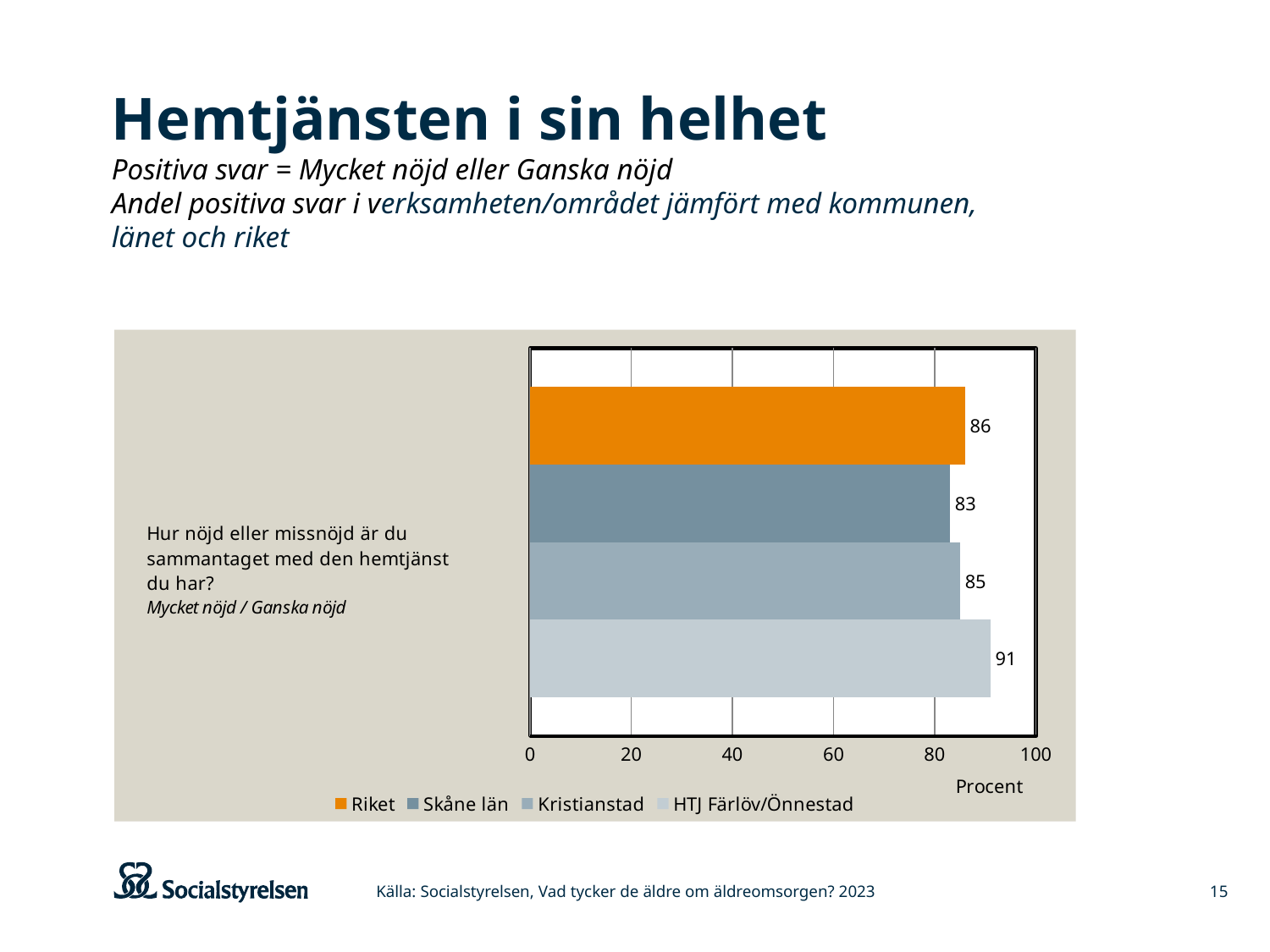
Which series has the lowest value? Skåne län What kind of chart is shown on the slide? Bar chart What is the value for Riket? 86 Which is larger, the value for Kristianstad or the value for Skåne län? Kristianstad Which series has the highest value? HTJ Färlöv/Önnestad What is the value for Kristianstad? 85 What is the value for Skåne län? 83 How many series does the legend list? 4 What is the difference between the values for HTJ Färlöv/Önnestad and Riket? 5 What is the label on the x axis of the chart? Procent What is the value for HTJ Färlöv/Önnestad? 91 What is the difference between the values for Riket and Skåne län? 3